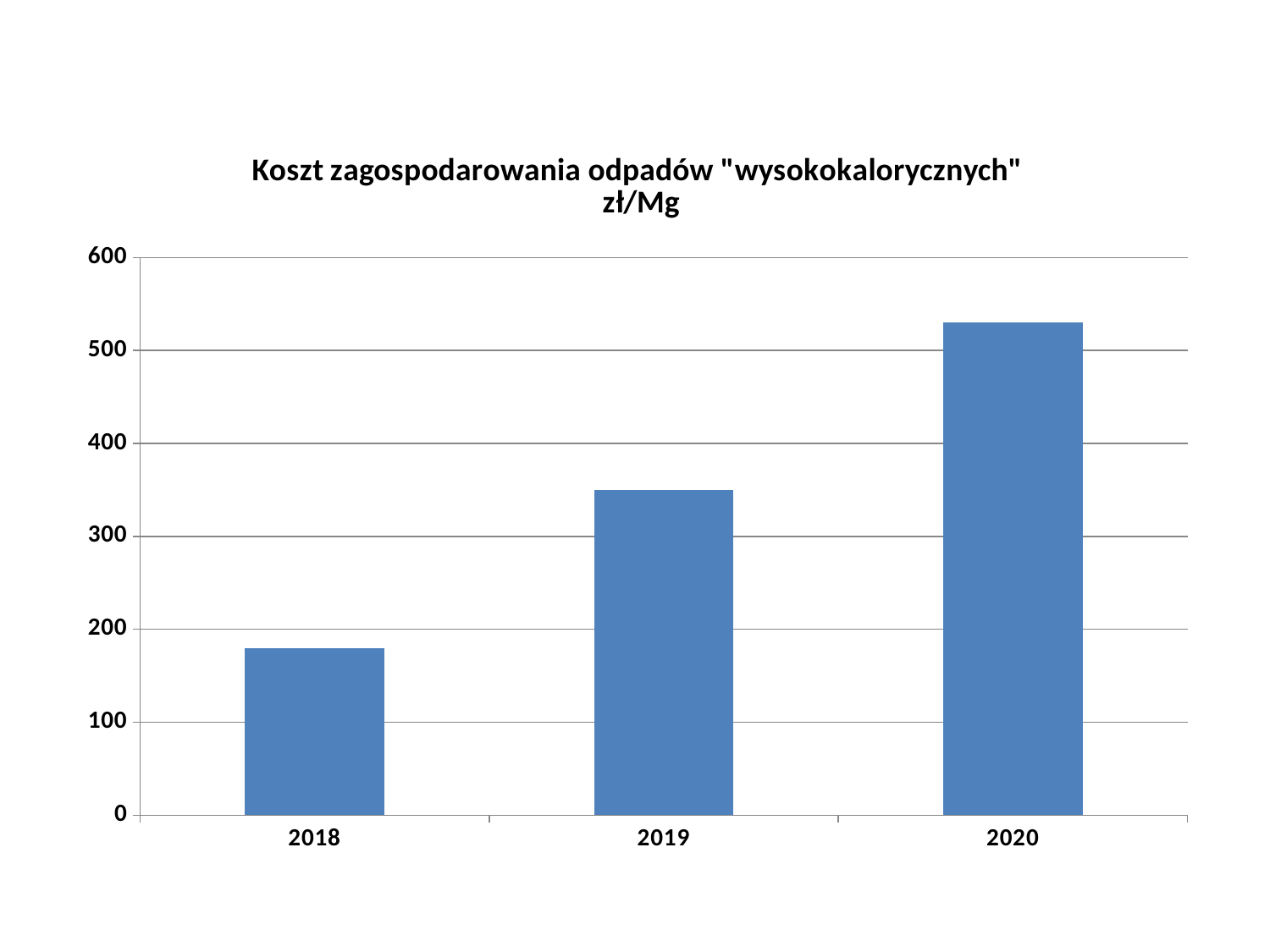
Which year has the lowest cost in the chart? 2018 Do the values rise or fall from 2018 to 2020? rise Is the value for 2020 greater or less than 500? greater Is the value for 2019 greater or less than 400? less Which year has the highest cost in the chart? 2020 Is the value for 2018 greater or less than 200? less How many years are shown on the x axis of the chart? 3 What is the title of the chart? Koszt zagospodarowania odpadów "wysokokalorycznych" zł/Mg What kind of chart is shown on the slide? bar chart Which is larger, the value for 2019 or the value for 2020? 2020